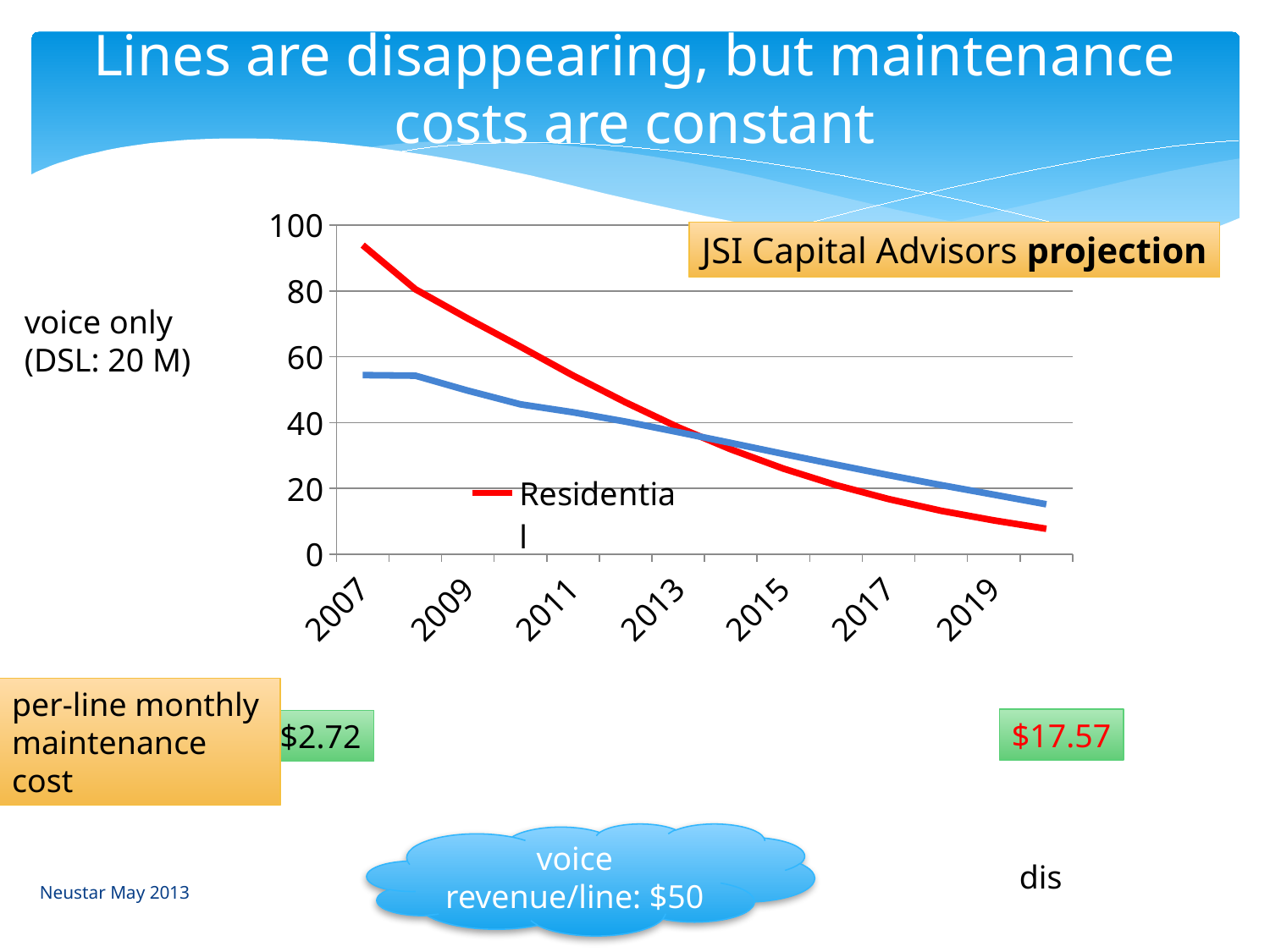
Is the value of the red Residential line in 2015 greater or less than 40? less In 2019, which line is higher, the red Residential line or the blue line? the blue line Is the value of the blue line in 2007 greater or less than 60? less Is the value of the red Residential line in 2007 greater or less than 80? greater What kind of chart is shown on the slide? line chart Does the red Residential line rise or fall from 2007 to 2019? fall In 2007, which line is higher, the red Residential line or the blue line? the red Residential line How many lines are plotted on the chart? 2 Does the blue line rise or fall from 2007 to 2019? fall How many year labels are shown on the x axis? 7